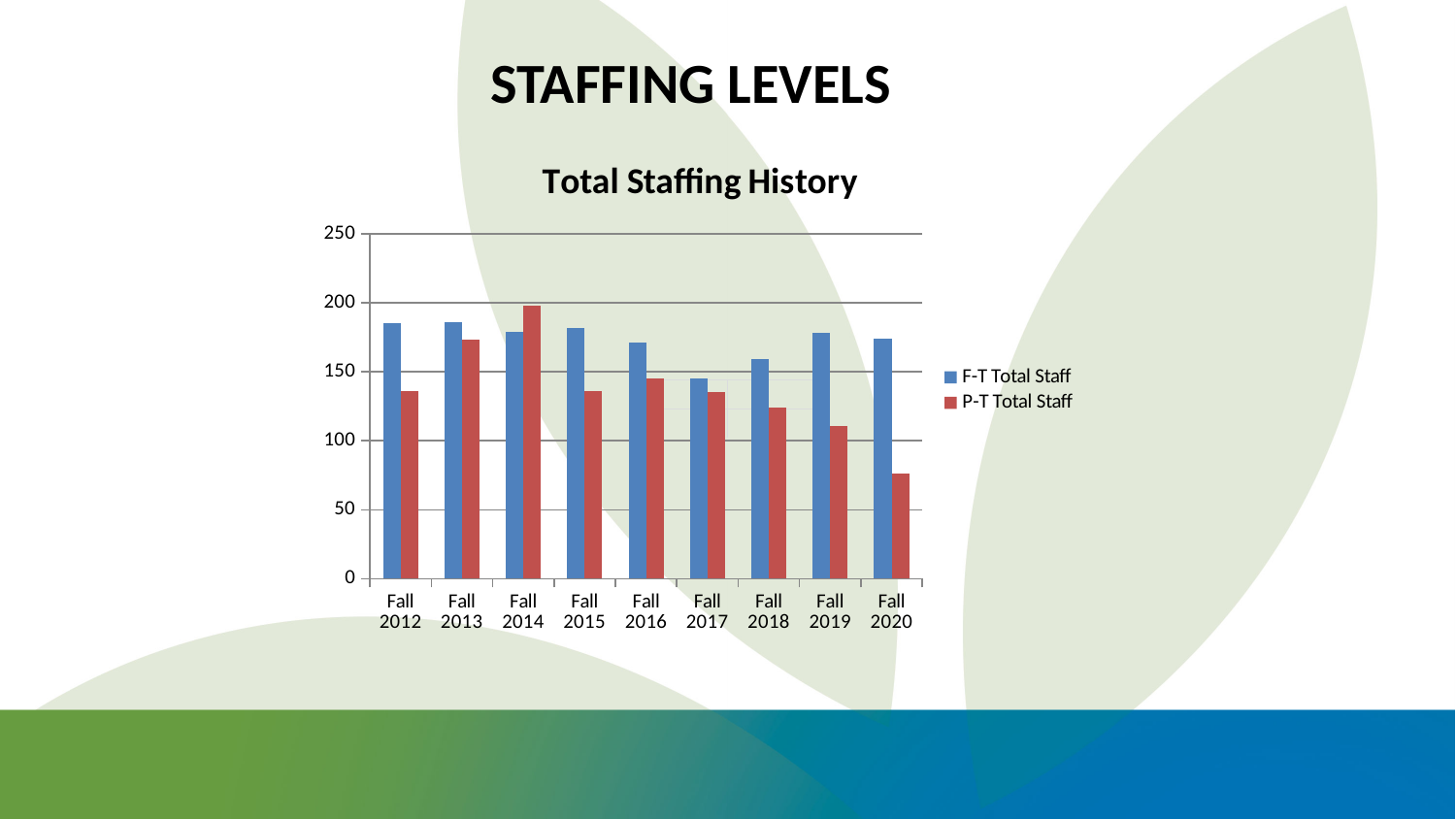
Is the value for F-T Total Staff in Fall 2012 greater or less than 150? greater Is the value for P-T Total Staff in Fall 2014 greater or less than 150? greater How many categories (semesters) are shown on the x axis? 9 What is the title of the chart? Total Staffing History How many series does the legend list? 2 In Fall 2014, which is larger: F-T Total Staff or P-T Total Staff? P-T Total Staff What kind of chart is shown on the slide? bar chart In which semester is F-T Total Staff lowest? Fall 2017 In which semester is P-T Total Staff highest? Fall 2014 In which semester is P-T Total Staff lowest? Fall 2020 Does P-T Total Staff rise or fall from Fall 2014 to Fall 2020? fall Is the value for P-T Total Staff in Fall 2020 greater or less than 100? less